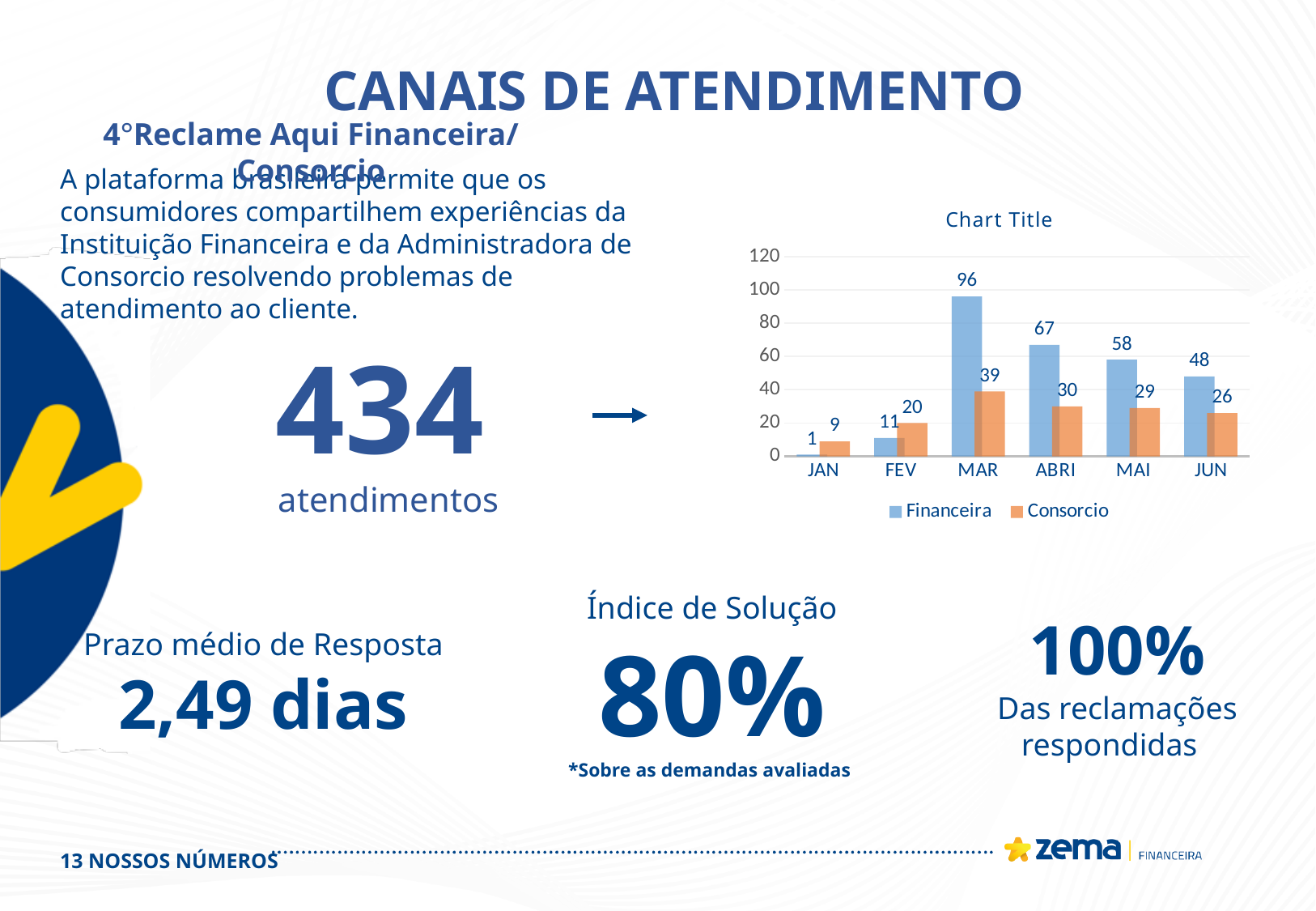
What is the value for Financeira in MAR? 96 How many months are shown on the x axis? 6 What kind of chart is shown? bar chart What is the value for Financeira in JAN? 1 Is the Financeira value for ABRI greater or less than 60? greater How many series does the legend list? 2 What is the difference between the Financeira and Consorcio values in MAR? 57 Which month has the lowest Consorcio value? JAN Does the Financeira value rise or fall from MAR to JUN? fall Which is larger in FEV, Financeira or Consorcio? Consorcio What is the value for Consorcio in JUN? 26 Which month has the highest Financeira value? MAR